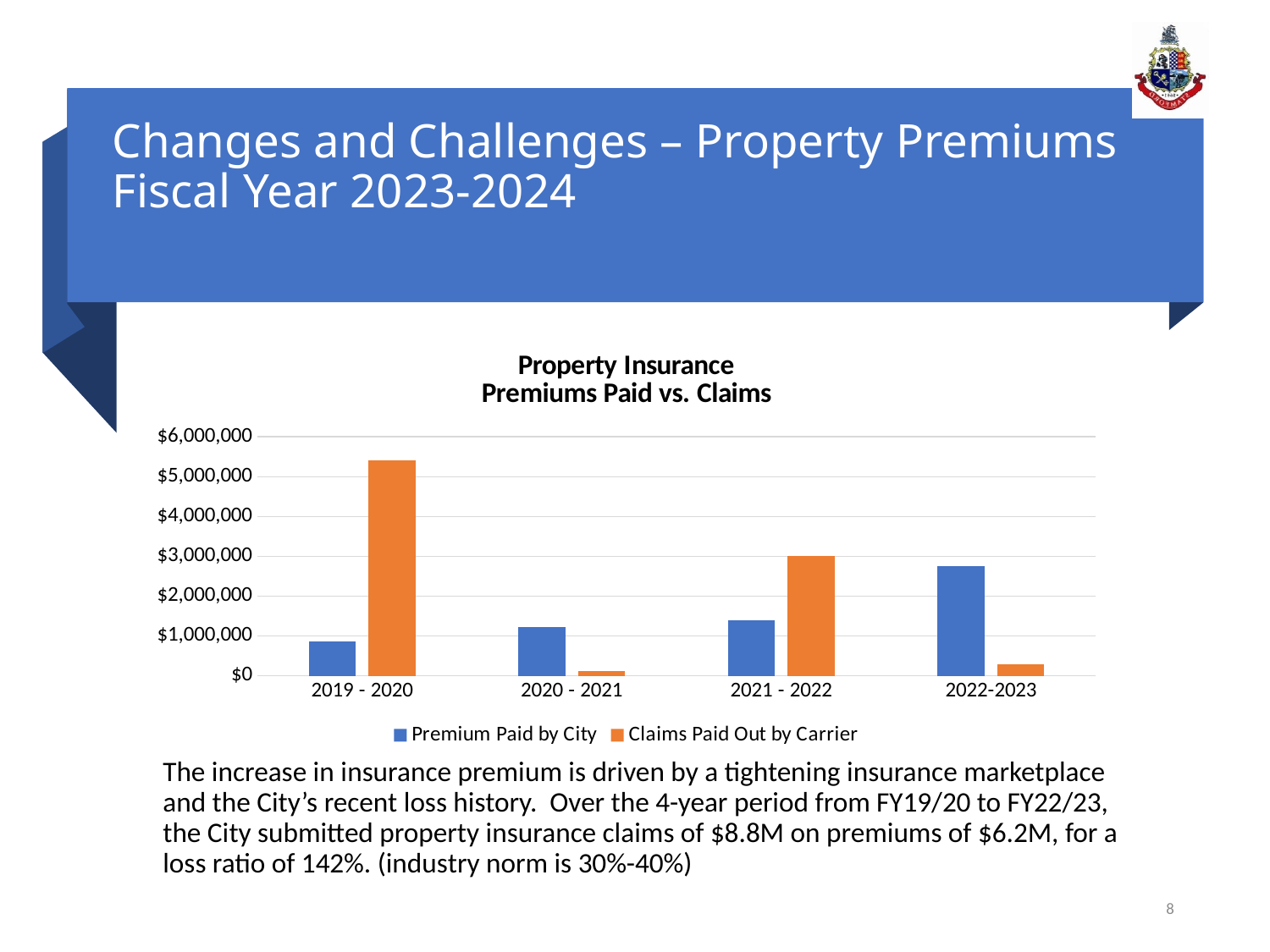
How many fiscal year categories are shown on the x axis? 4 How many series does the legend list? 2 Is the value for Premium Paid by City in 2022-2023 greater or less than $2,000,000? greater Does the Premium Paid by City rise or fall from 2019 - 2020 to 2022-2023? rise In which fiscal year was the Premium Paid by City the lowest? 2019 - 2020 Is the value for Claims Paid Out by Carrier in 2019 - 2020 greater or less than $5,000,000? greater What kind of chart is shown on the slide? bar chart In which fiscal year was the Premium Paid by City the highest? 2022-2023 For 2022-2023, which is larger: Premium Paid by City or Claims Paid Out by Carrier? Premium Paid by City In which fiscal year were Claims Paid Out by Carrier the lowest? 2020 - 2021 In which fiscal year were Claims Paid Out by Carrier the highest? 2019 - 2020 For 2019 - 2020, which is larger: Premium Paid by City or Claims Paid Out by Carrier? Claims Paid Out by Carrier